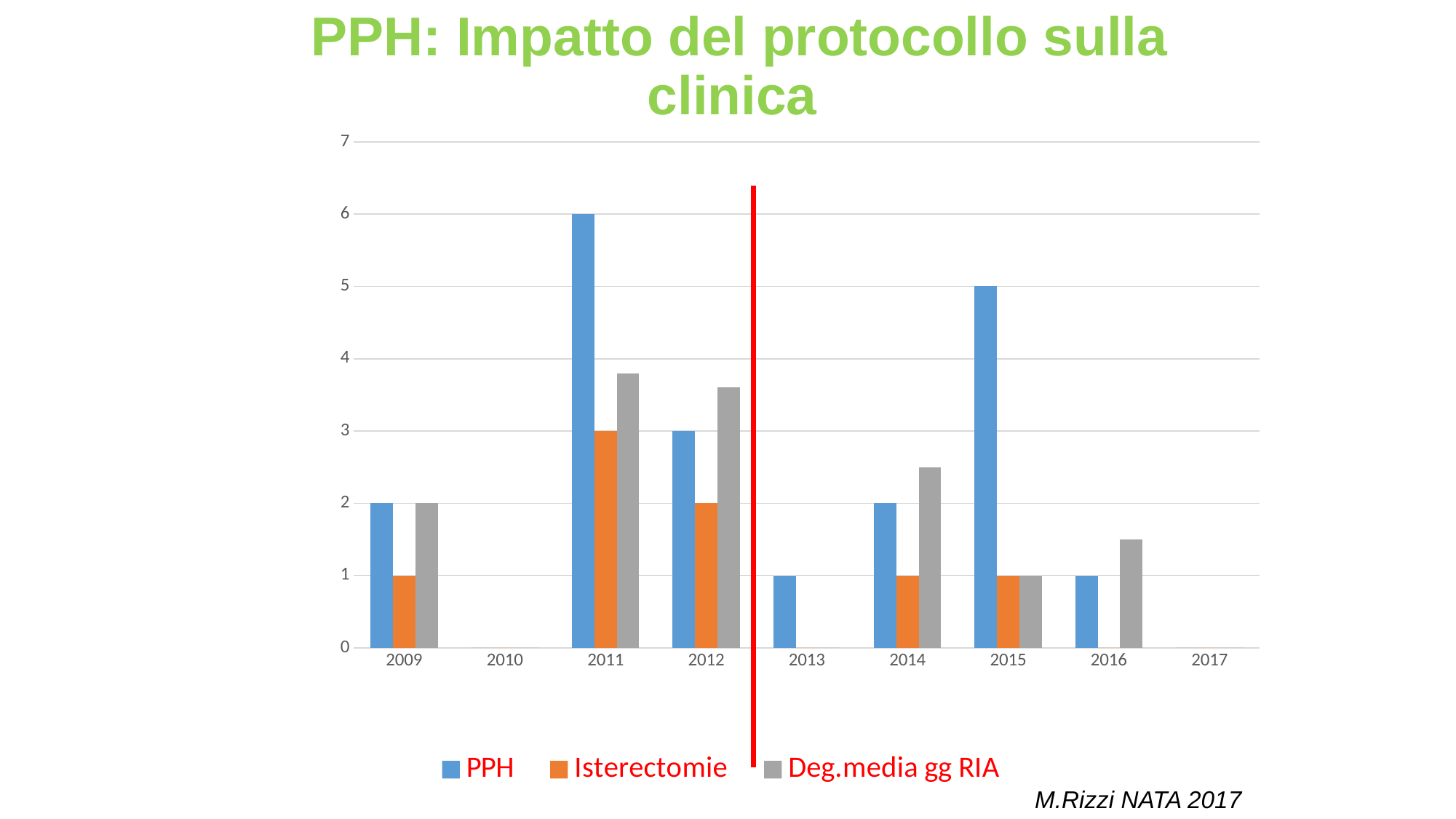
In which year is the PPH value highest? 2011 How many years are shown on the x axis? 9 Which series is shown in orange in the legend? Isterectomie What kind of chart is shown on the slide? bar chart How many series does the legend list? 3 What is the Isterectomie value for 2011? 3 What is the PPH value for 2015? 5 What is the PPH value for 2011? 6 What is the difference between the PPH values for 2011 and 2012? 3 Which year has the larger PPH value, 2011 or 2015? 2011 Is the Deg.media gg RIA value for 2011 greater or less than 3? greater Is the Deg.media gg RIA value for 2014 greater or less than 2? greater